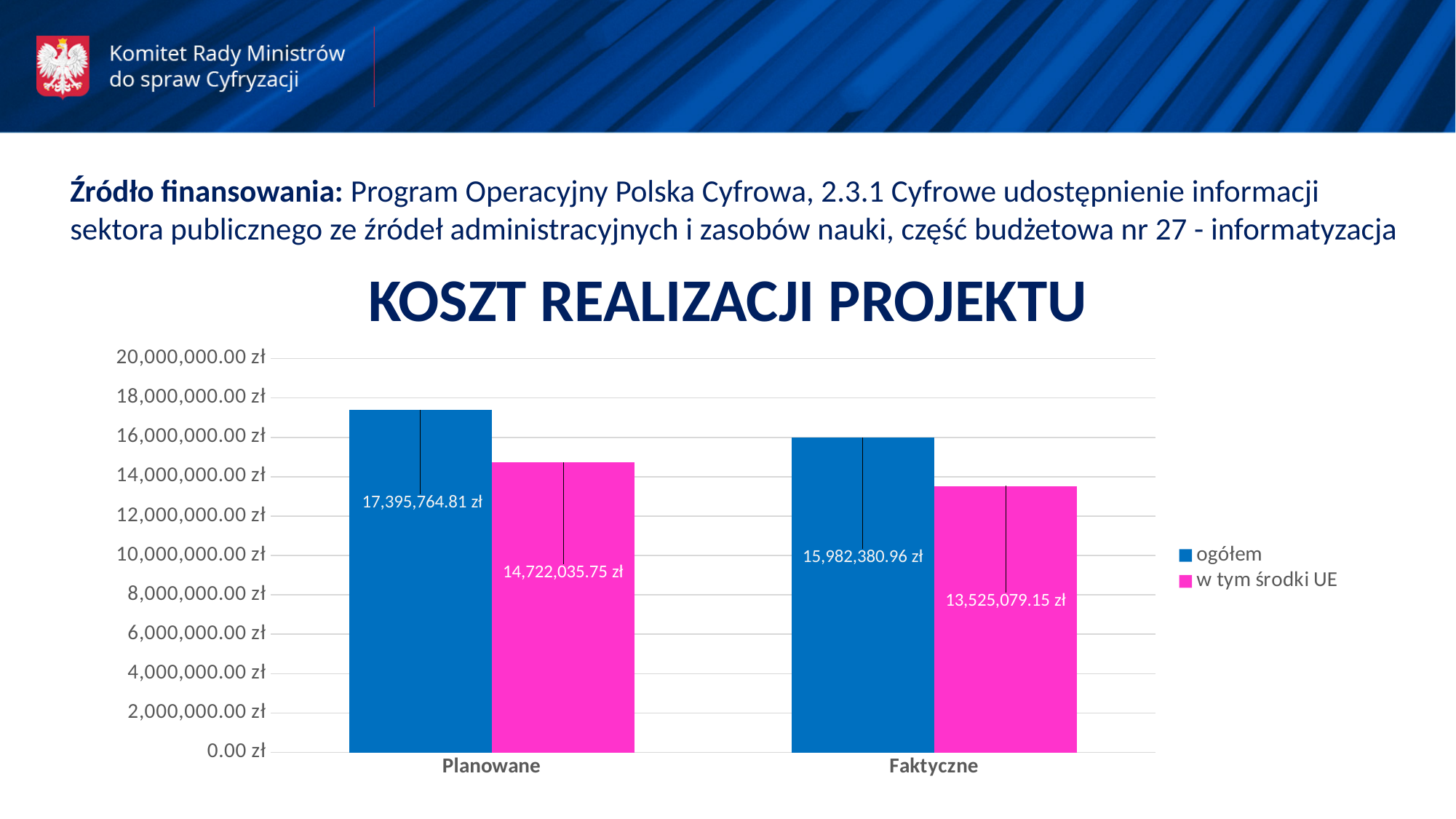
What is the value of 'w tym środki UE' for Planowane? 14,722,035.75 zł What is the value of 'ogółem' for Planowane? 17,395,764.81 zł What is the value of 'ogółem' for Faktyczne? 15,982,380.96 zł What type of chart is shown on the slide? bar chart Which bar has the lowest value in the chart? w tym środki UE for Faktyczne What is the title of the chart? KOSZT REALIZACJI PROJEKTU What is the difference between 'ogółem' and 'w tym środki UE' for Planowane? 2,673,729.06 zł How many series does the legend list? 2 What is the value of 'w tym środki UE' for Faktyczne? 13,525,079.15 zł Which bar has the highest value in the chart? ogółem for Planowane Is the 'ogółem' value for Faktyczne greater or less than 16,000,000.00 zł? less How many categories are shown on the x axis? 2